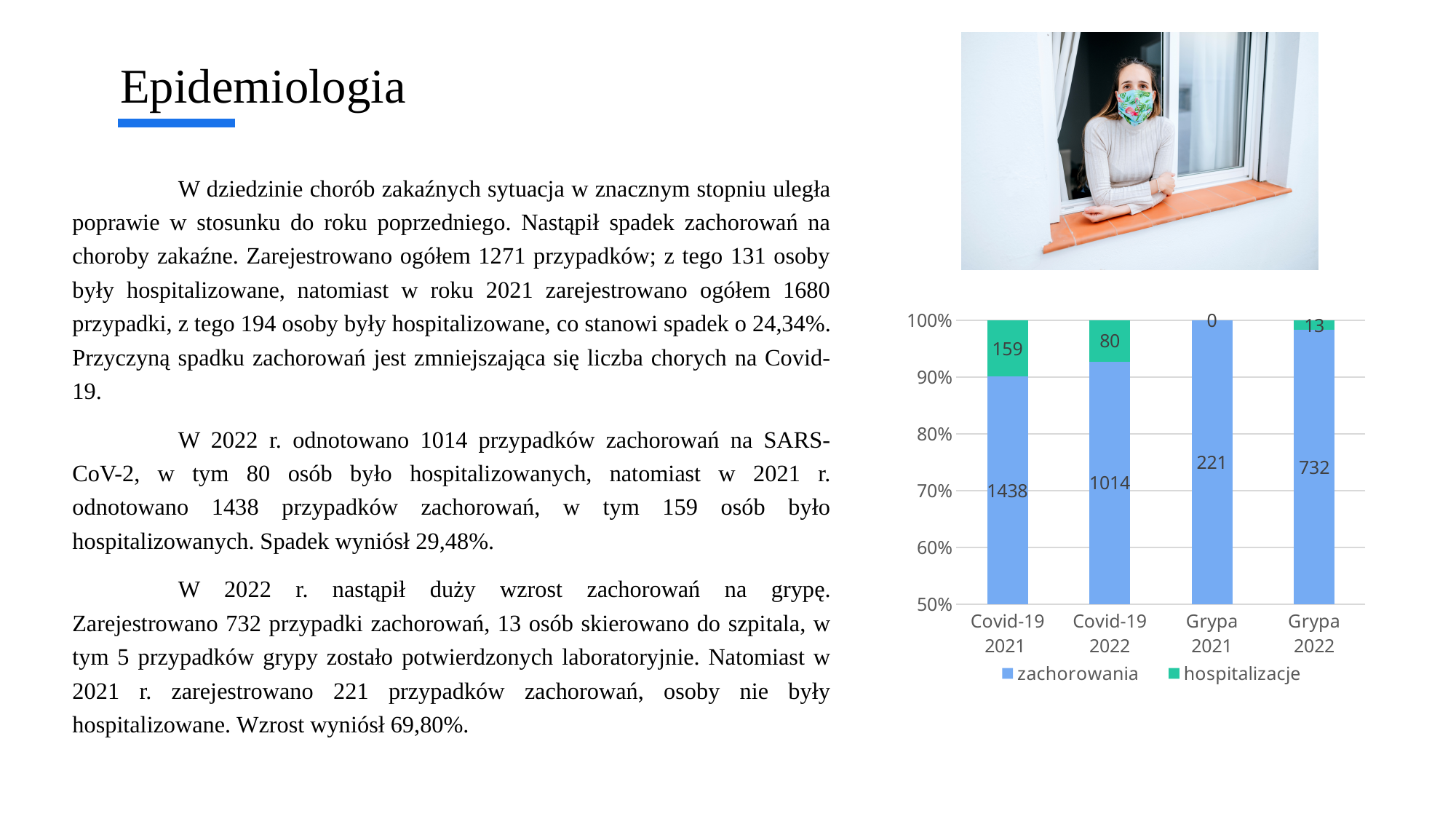
What is the difference between zachorowania for Covid-19 2021 and Covid-19 2022? 424 What is the value for zachorowania for Covid-19 2021? 1438 What kind of chart is shown on the slide? Stacked bar chart What is the value for hospitalizacje for Covid-19 2022? 80 What is the total of the labelled values in the Covid-19 2022 bar? 1094 Which is larger: hospitalizacje for Covid-19 2021 or for Grypa 2022? Covid-19 2021 What is the value for zachorowania for Grypa 2022? 732 Which category has the lowest value for hospitalizacje? Grypa 2021 What is the value for hospitalizacje for Grypa 2021? 0 How many categories are shown on the x axis of the chart? 4 Which category has the highest value for zachorowania? Covid-19 2021 How many series does the chart legend list? 2